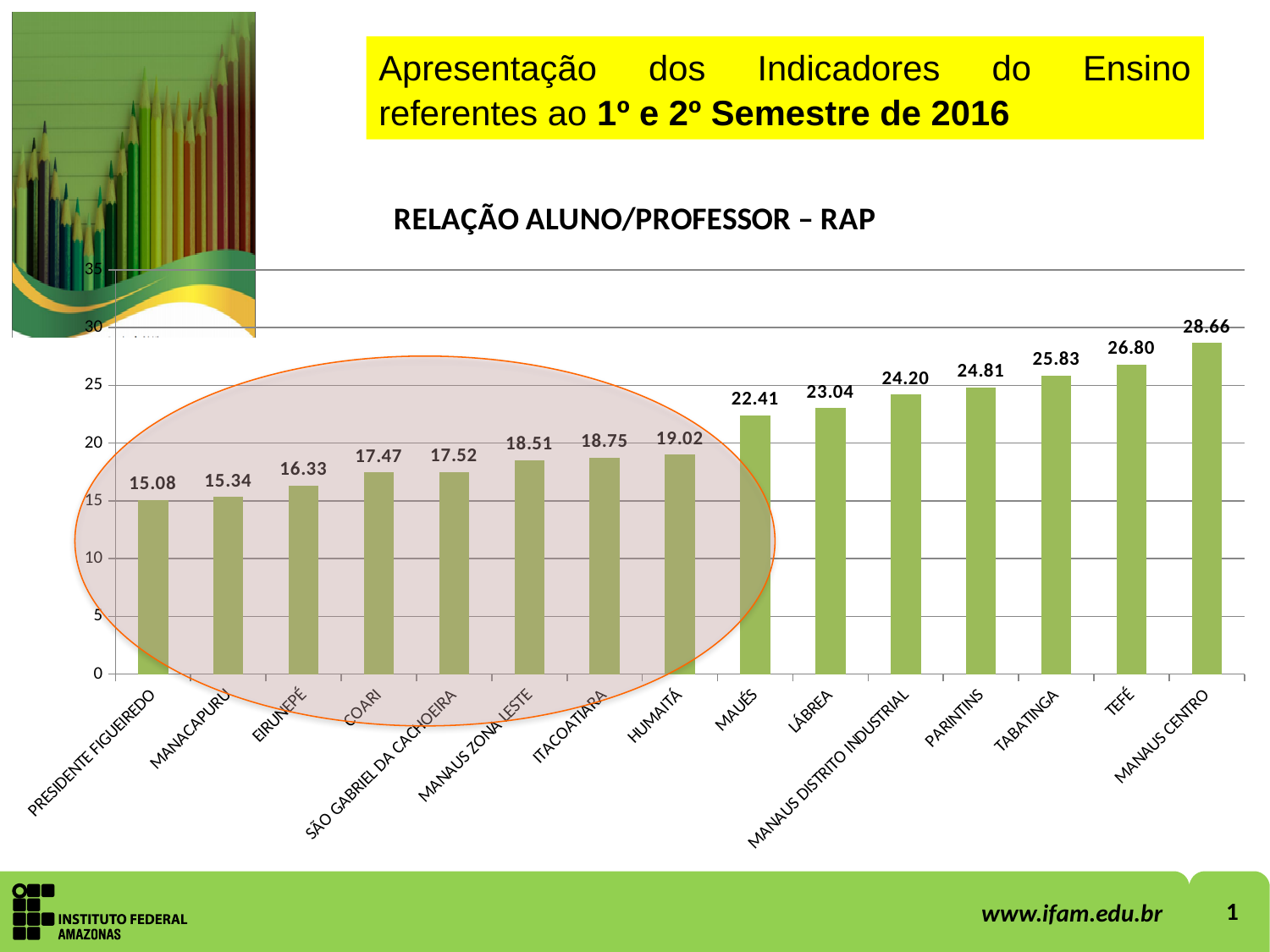
Which category has the lowest value? Presidente Figueiredo What is the value for Eirunepé? 16.33 Is the value for Tabatinga greater or less than 25? greater Do the values rise or fall from left to right along the x axis? Rise What is the difference between the values for Manaus Centro and Presidente Figueiredo? 13.58 What is the value for Manaus Centro? 28.66 What kind of chart is shown on the slide? Bar chart How many categories are shown in the chart? 15 Which is larger, the value for Lábrea or the value for Humaitá? Lábrea What is the difference between the values for Tefé and Maués? 4.39 What is the value for Parintins? 24.81 Which category has the highest value? Manaus Centro